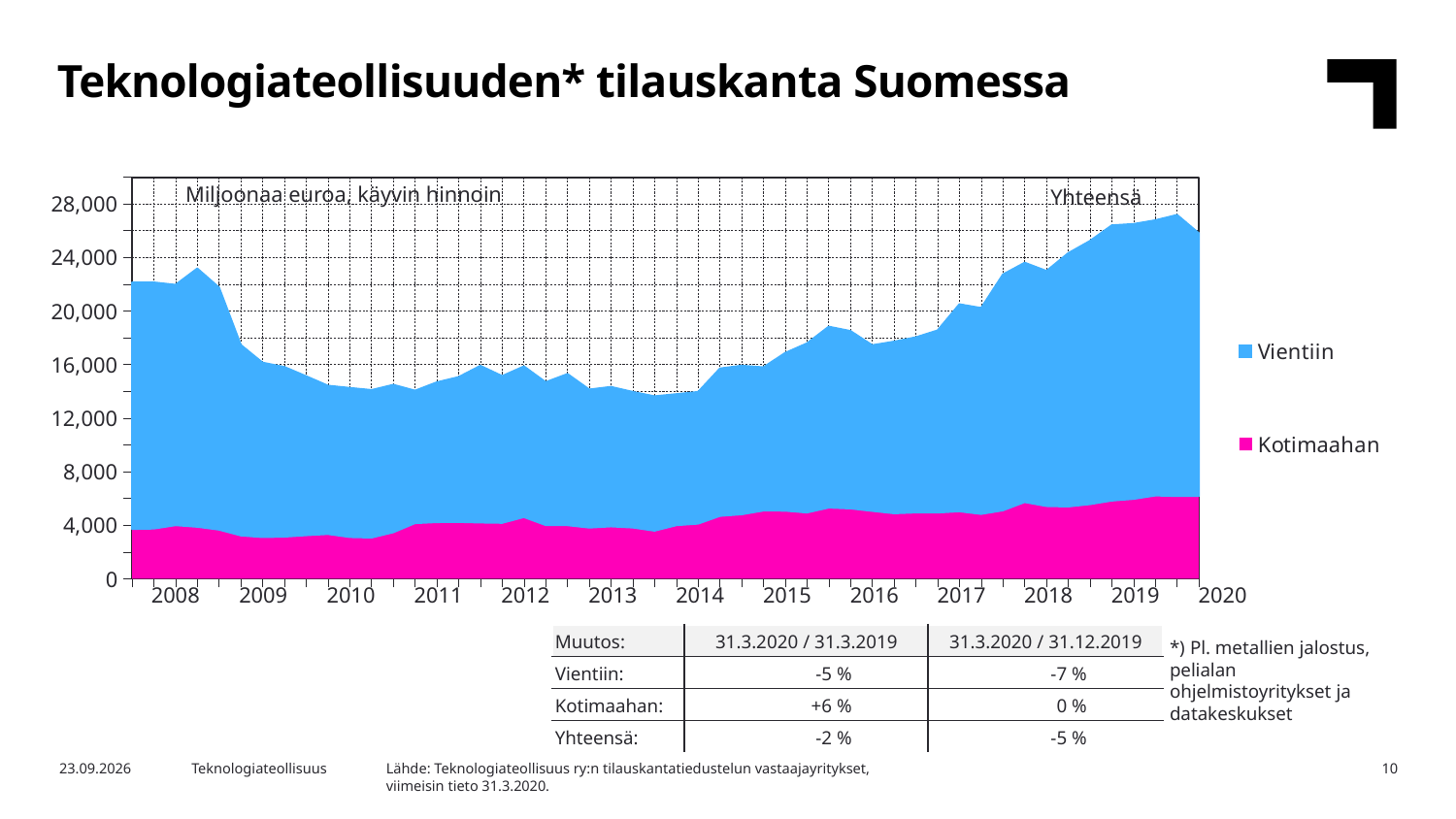
Does the total (Yhteensä) rise or fall between 2013 and 2019? rise Which is larger, the total (Yhteensä) value in 2019 or in 2013? 2019 What kind of chart is shown on the slide? Stacked area chart How many year labels are shown on the x axis? 13 Is the Kotimaahan value in 2019 greater or less than 4,000? greater What unit is stated in the chart's label at the top left of the plot area? Miljoonaa euroa, käyvin hinnoin Is the Kotimaahan value in 2010 greater or less than 8,000? less What are the two series named in the legend? Vientiin and Kotimaahan Is the total (Yhteensä) value in 2013 greater or less than 16,000? less How many series does the legend list? 2